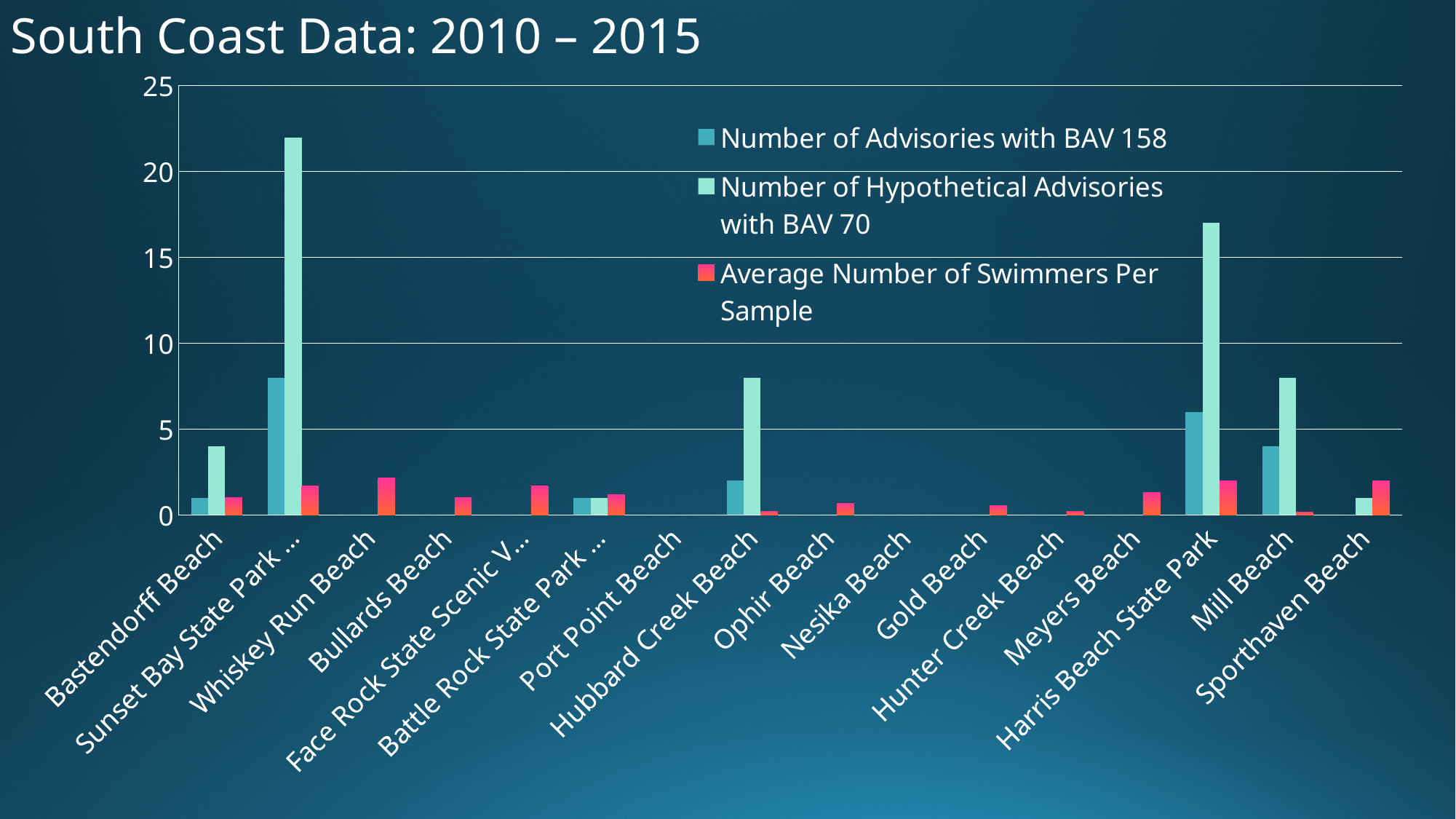
Which beach has the highest Number of Advisories with BAV 158? Sunset Bay State Park Which has the larger Number of Advisories with BAV 158, Sunset Bay State Park or Harris Beach State Park? Sunset Bay State Park How many series does the legend list? 3 Which beach has the highest Number of Hypothetical Advisories with BAV 70? Sunset Bay State Park What kind of chart is shown on the slide? bar chart What is the title of the slide? South Coast Data: 2010 – 2015 Is the Number of Hypothetical Advisories with BAV 70 for Harris Beach State Park greater or less than 15? greater Is the Number of Hypothetical Advisories with BAV 70 for Mill Beach greater or less than 10? less Is the Number of Advisories with BAV 158 for Harris Beach State Park greater or less than 5? greater How many beaches are shown along the x axis? 16 Which has the larger Number of Hypothetical Advisories with BAV 70, Harris Beach State Park or Mill Beach? Harris Beach State Park